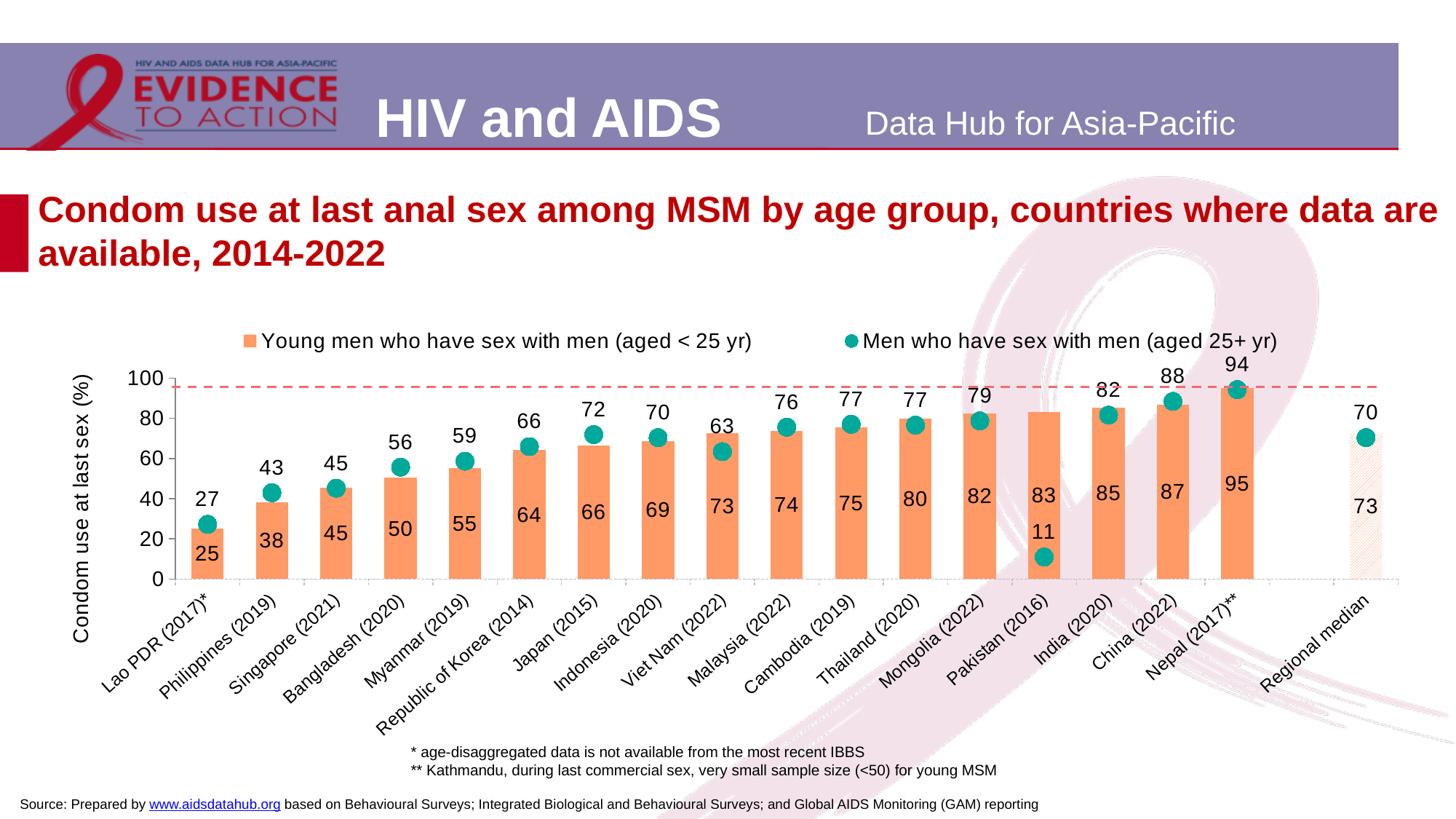
In Japan (2015), which group has the higher value: young MSM (aged < 25 yr) or MSM aged 25+ yr? Men who have sex with men (aged 25+ yr) What kind of chart is used to show the young MSM (aged < 25 yr) values? Bar chart Which country has the lowest value for men who have sex with men (aged 25+ yr)? Pakistan (2016) Do the values for young MSM (aged < 25 yr) rise or fall from Lao PDR (2017)* to Nepal (2017)**? Rise What is the regional median value for young men who have sex with men (aged < 25 yr)? 73 Which country has the highest value for young men who have sex with men (aged < 25 yr)? Nepal (2017)** How many series does the legend list? 2 What is the label of the y axis? Condom use at last sex (%) What is the value for young men who have sex with men (aged < 25 yr) in Thailand (2020)? 80 How many categories are shown on the x axis of the chart? 18 In Viet Nam (2022), what is the difference between the value for young MSM (aged < 25 yr) and MSM aged 25+ yr? 10 What is the value for men who have sex with men (aged 25+ yr) in Pakistan (2016)? 11